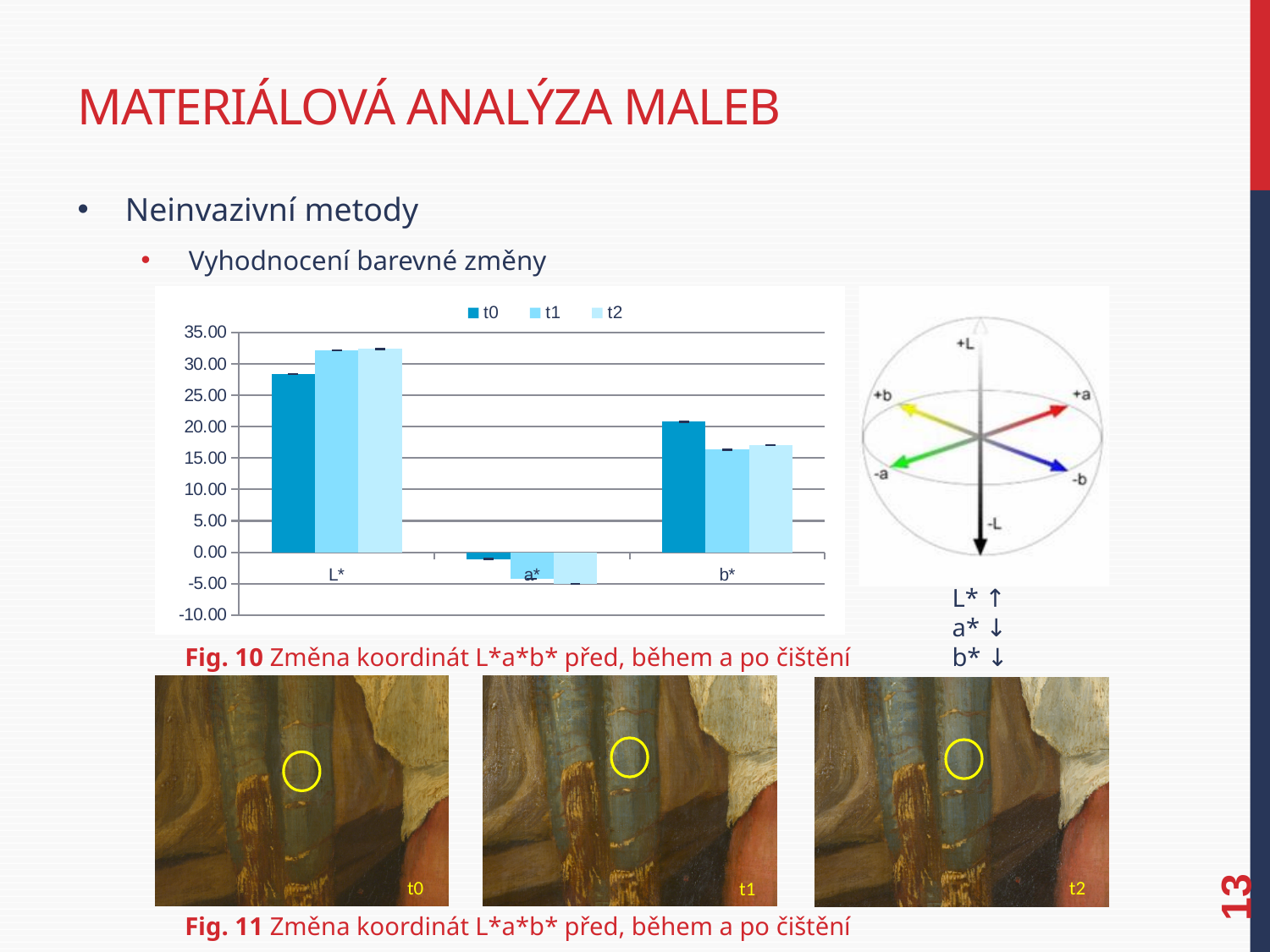
Which category has the lowest bars in the chart? a* For category b*, which series has the larger value, t0 or t1? t0 Which category has the highest bars in the chart? L* Is the value for L* in series t0 greater or less than 25.00? greater Is the value for a* in series t2 greater or less than 0.00? less Is the value for L* in series t1 greater or less than 30.00? greater What kind of chart is shown on the slide? bar chart What are the series names listed in the chart legend? t0, t1, t2 For category L*, which series has the larger value, t0 or t1? t1 How many categories are shown on the x axis of the chart? 3 How many series does the chart legend list? 3